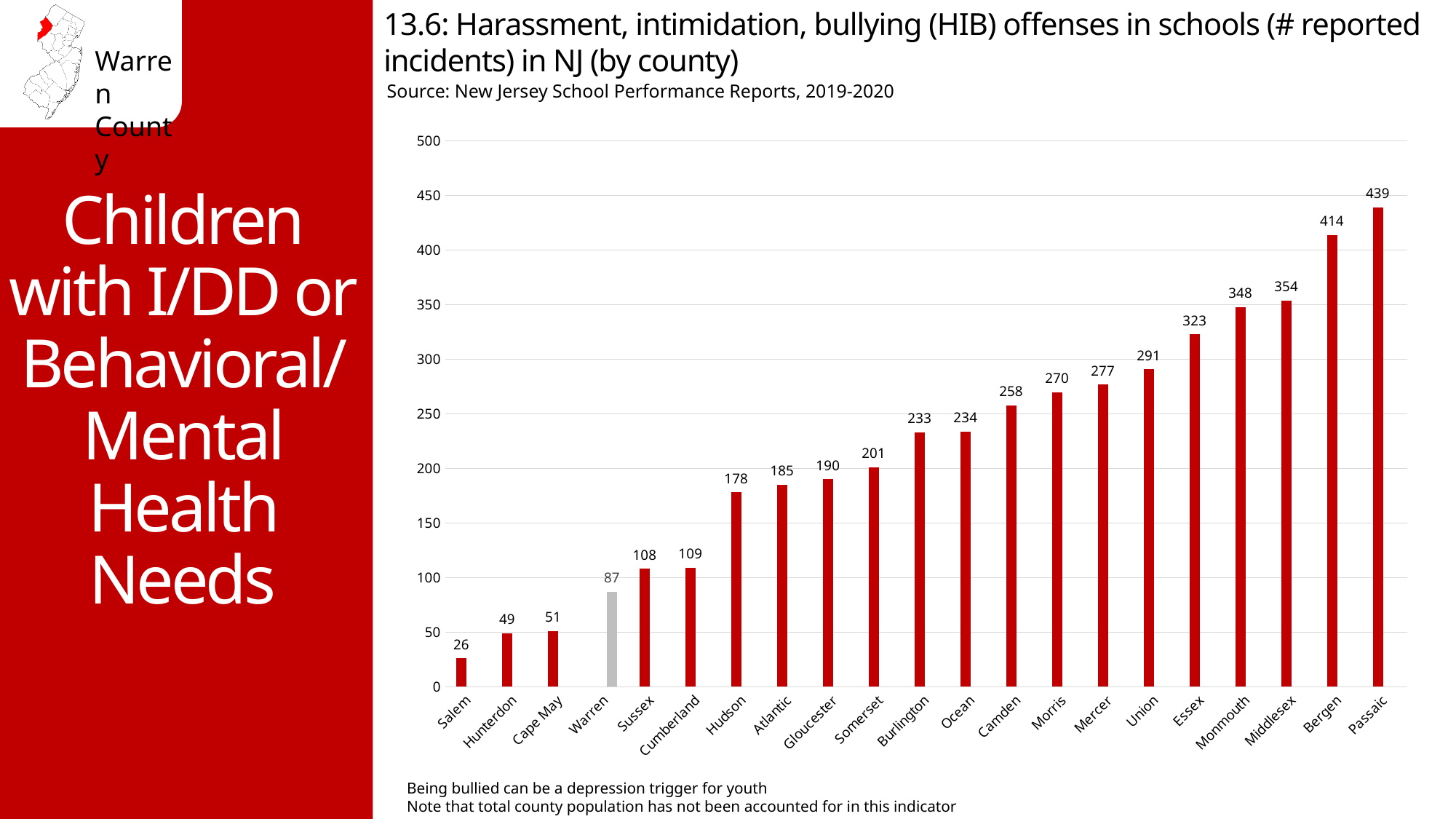
Which county has the highest number of reported HIB incidents? Passaic What is the number of reported HIB incidents for Bergen County? 414 Which county has the lowest number of reported HIB incidents? Salem What is the difference in reported HIB incidents between Passaic and Warren? 352 Is the value for Monmouth greater or less than 300? greater Do the values rise or fall moving from left to right along the x axis? Rise What is the source cited for the chart data? New Jersey School Performance Reports, 2019-2020 What is the number of reported HIB incidents for Warren County? 87 Which county has more reported HIB incidents, Essex or Camden? Essex Which county's bar is shown in gray rather than red? Warren What kind of chart is used to show the HIB incidents by county? Bar chart How many counties are shown on the chart? 21